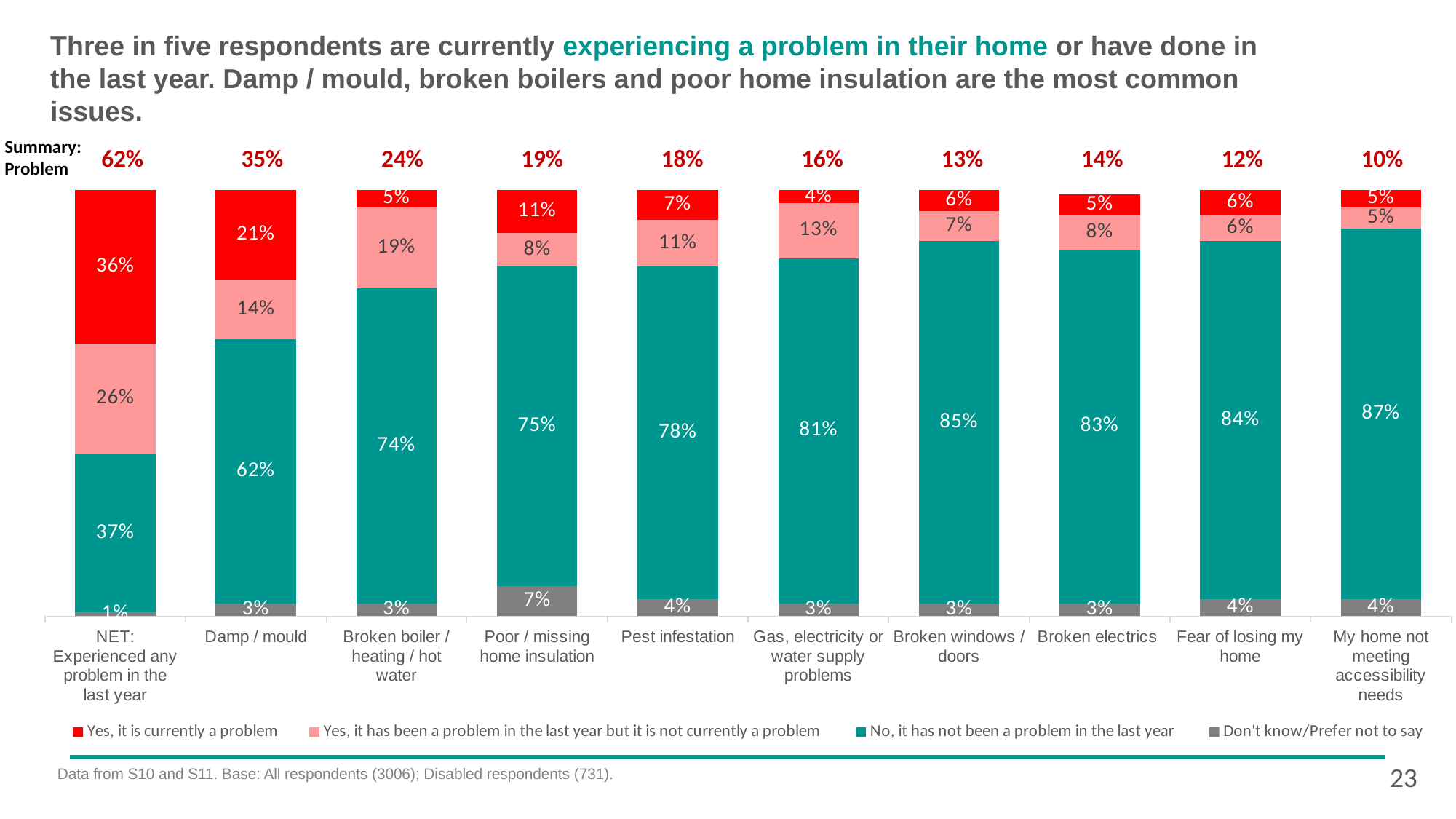
What is the 'Don't know/Prefer not to say' value for poor / missing home insulation? 7% What percentage of respondents say a broken boiler / heating / hot water has not been a problem in the last year? 74% What percentage of respondents say damp / mould is currently a problem? 21% How many series does the legend list? 4 What kind of chart is shown on the slide? Stacked bar chart Which colour represents 'Yes, it is currently a problem' in the legend? Red What is the Summary: Problem figure shown above the pest infestation bar? 18% How many categories are shown on the x axis of the chart? 10 Excluding the NET bar, which category has the lowest Summary: Problem figure? My home not meeting accessibility needs Which is larger: the 'has been a problem in the last year but not currently' value for broken boiler / heating / hot water or for gas, electricity or water supply problems? Broken boiler / heating / hot water What is the difference between the 'currently a problem' values for damp / mould and poor / missing home insulation? 10% Which category has the highest 'No, it has not been a problem in the last year' value? My home not meeting accessibility needs